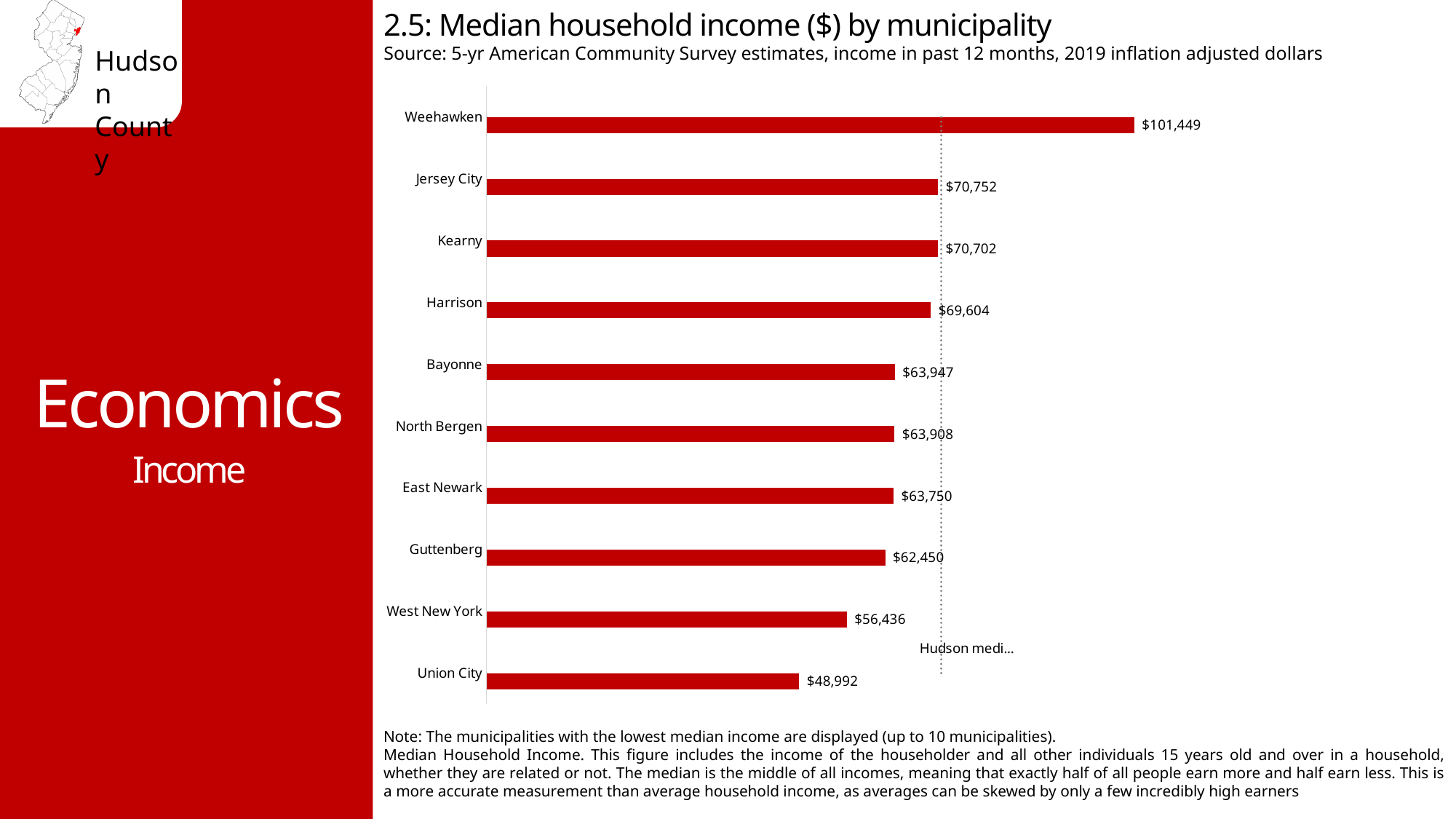
Which municipality has the lowest median household income on the chart? Union City What is the median household income for Weehawken? $101,449 How many municipalities are shown on the chart? 10 What is the difference in median household income between Jersey City and Kearny? $50 Which has a higher median household income, Harrison or Guttenberg? Harrison Which municipality has the highest median household income on the chart? Weehawken What is the difference in median household income between Weehawken and Union City? $52,457 What is the median household income for West New York? $56,436 What is the title of the chart? 2.5: Median household income ($) by municipality What is the median household income for Bayonne? $63,947 What is the median household income for Union City? $48,992 What type of chart is used to show median household income by municipality? Bar chart